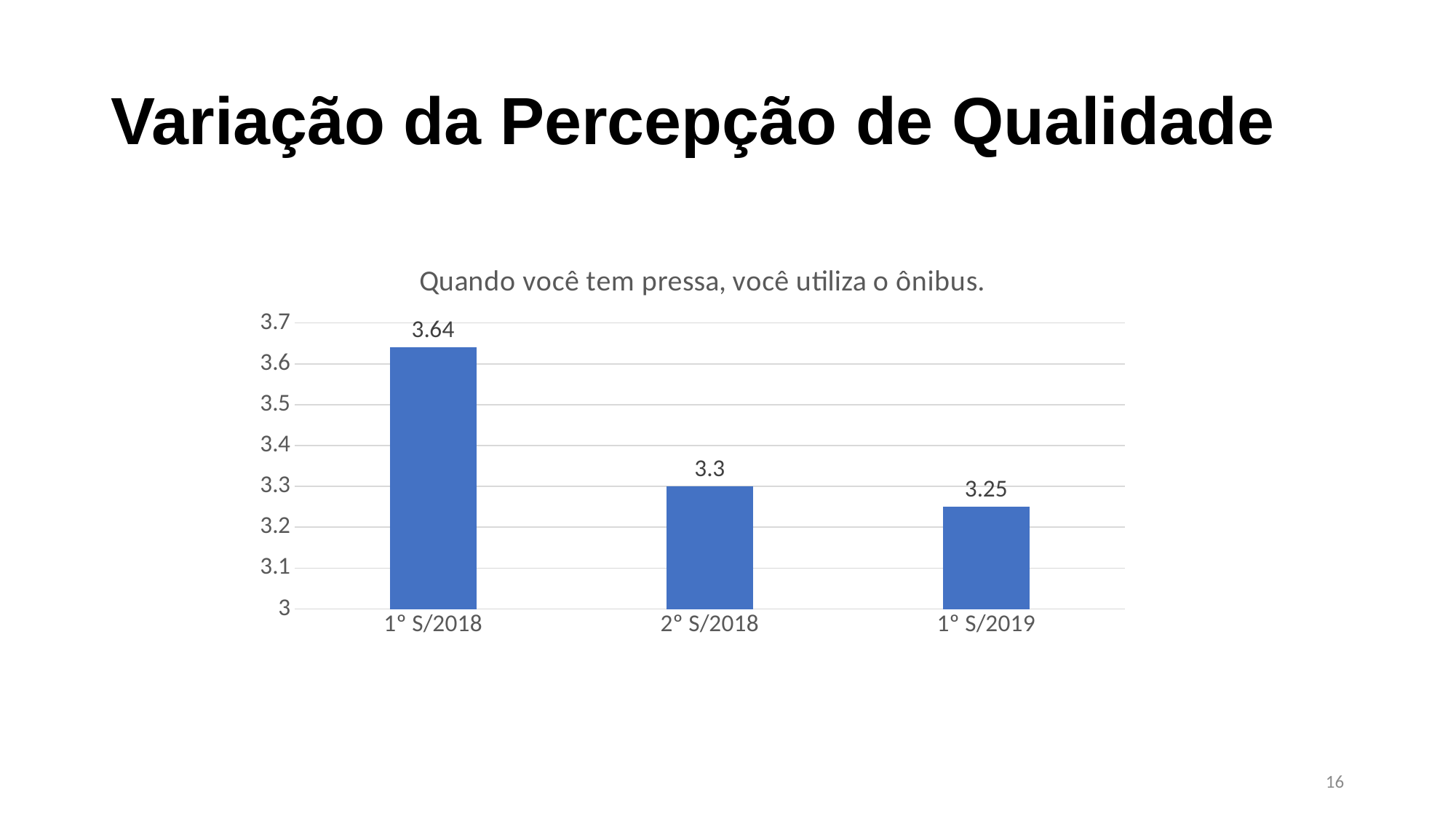
What is the value for 1° S/2018? 3.64 What is the value for 2° S/2018? 3.3 Which period has the highest value? 1° S/2018 What is the difference between the values for 2° S/2018 and 1° S/2019? 0.05 Which is larger, the value for 1° S/2018 or the value for 2° S/2018? 1° S/2018 What is the value for 1° S/2019? 3.25 What is the difference between the values for 1° S/2018 and 1° S/2019? 0.39 How many periods are shown on the x axis? 3 Do the values rise or fall from 1° S/2018 to 1° S/2019? fall Is the value for 1° S/2018 greater or less than 3.5? greater Which period has the lowest value? 1° S/2019 What kind of chart is shown on the slide? bar chart